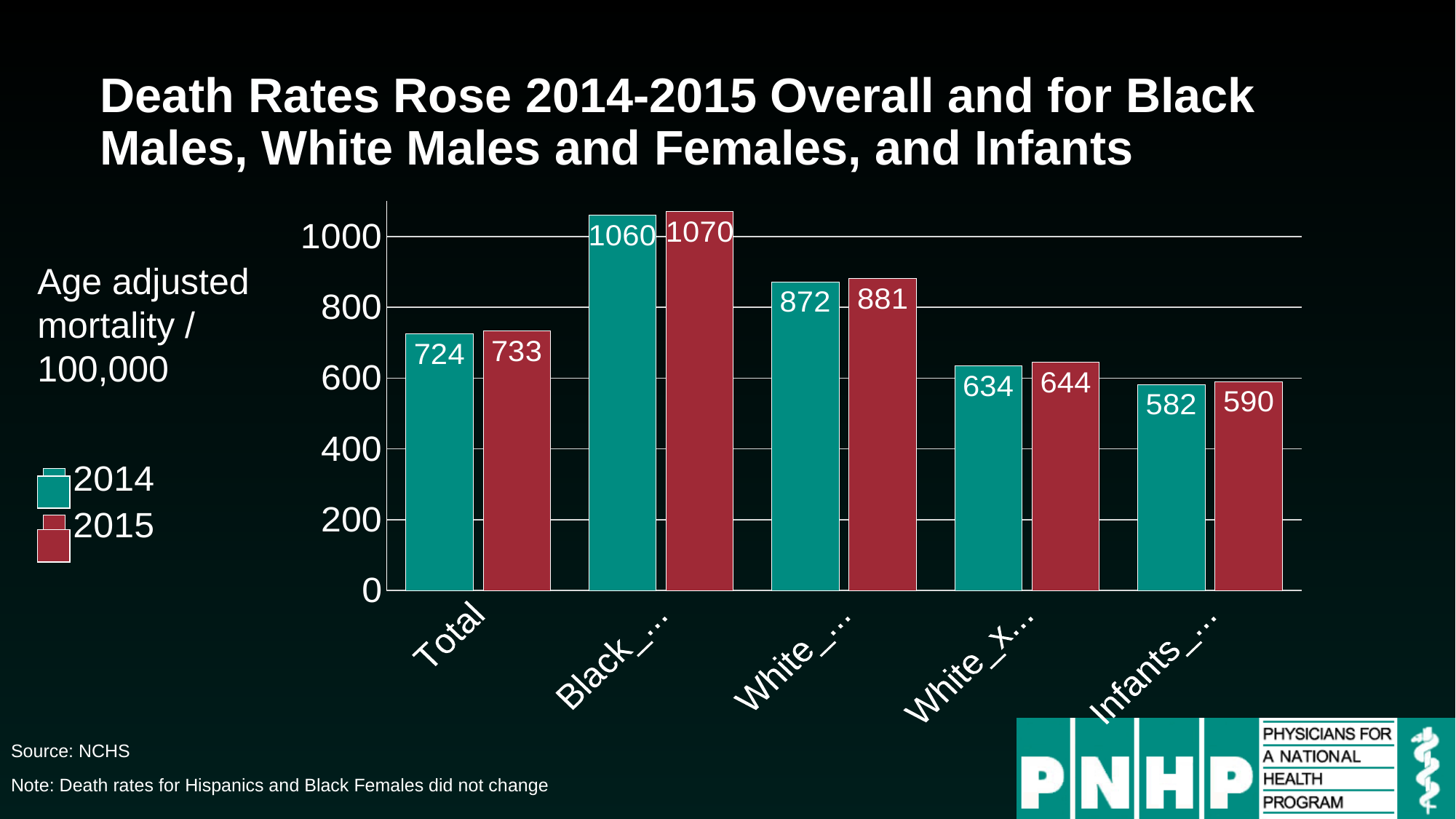
What is the 2015 value for the second category from the left (labelled 'Black_...')? 1070 Which category has the highest 2014 value? Black_... (second from the left) How many series does the legend list? 2 What is the 2015 value for Total? 733 What is the difference between the 2015 and 2014 values for Total? 9 How many categories are shown on the x axis? 5 What is the 2014 value for the rightmost category (labelled 'Infants_...')? 582 What is the 2014 value for Total? 724 Which category has the lowest 2015 value? Infants_... (rightmost) What kind of chart is shown on the slide? Bar chart What is the difference between the 2015 and 2014 values for the fourth category from the left (labelled 'White_X...')? 10 Which is larger, the 2014 value for Total or the 2014 value for the third category from the left (labelled 'White_...')? White_... (872)